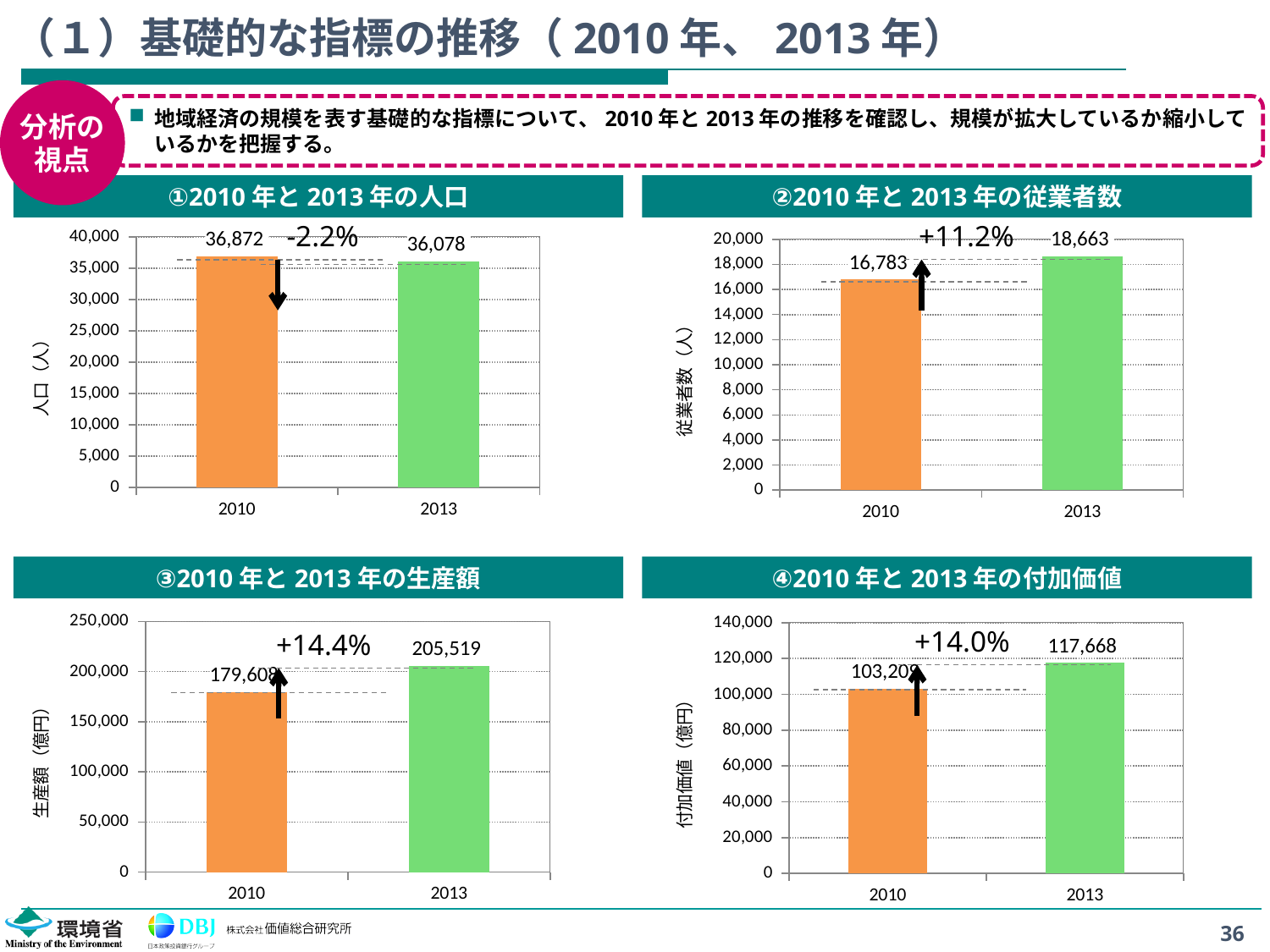
In the top-left chart (①2010年と2013年の人口), what is the population value for 2013? 36,078 In the bottom-left chart (③2010年と2013年の生産額), what is the value for 2010? 179,608 In the bottom-right chart (④2010年と2013年の付加価値), what is the difference between the 2013 and 2010 values? 14,459 In the bottom-left chart (③2010年と2013年の生産額), what percentage change is printed between 2010 and 2013? +14.4% What kind of chart is the bottom-right chart (④2010年と2013年の付加価値)? Bar chart In the top-right chart (②2010年と2013年の従業者数), what is the value for 2013? 18,663 In the top-right chart (②2010年と2013年の従業者数), what is the difference between the 2013 and 2010 values? 1,880 In the bottom-right chart (④2010年と2013年の付加価値), what is the value for 2013? 117,668 In the top-right chart (②2010年と2013年の従業者数), which year has the higher value? 2013 In the top-left chart (①2010年と2013年の人口), what percentage change is printed between 2010 and 2013? -2.2% In the top-left chart (①2010年と2013年の人口), by how much did the population decrease from 2010 to 2013? 794 In the top-left chart (①2010年と2013年の人口), what is the population value for 2010? 36,872